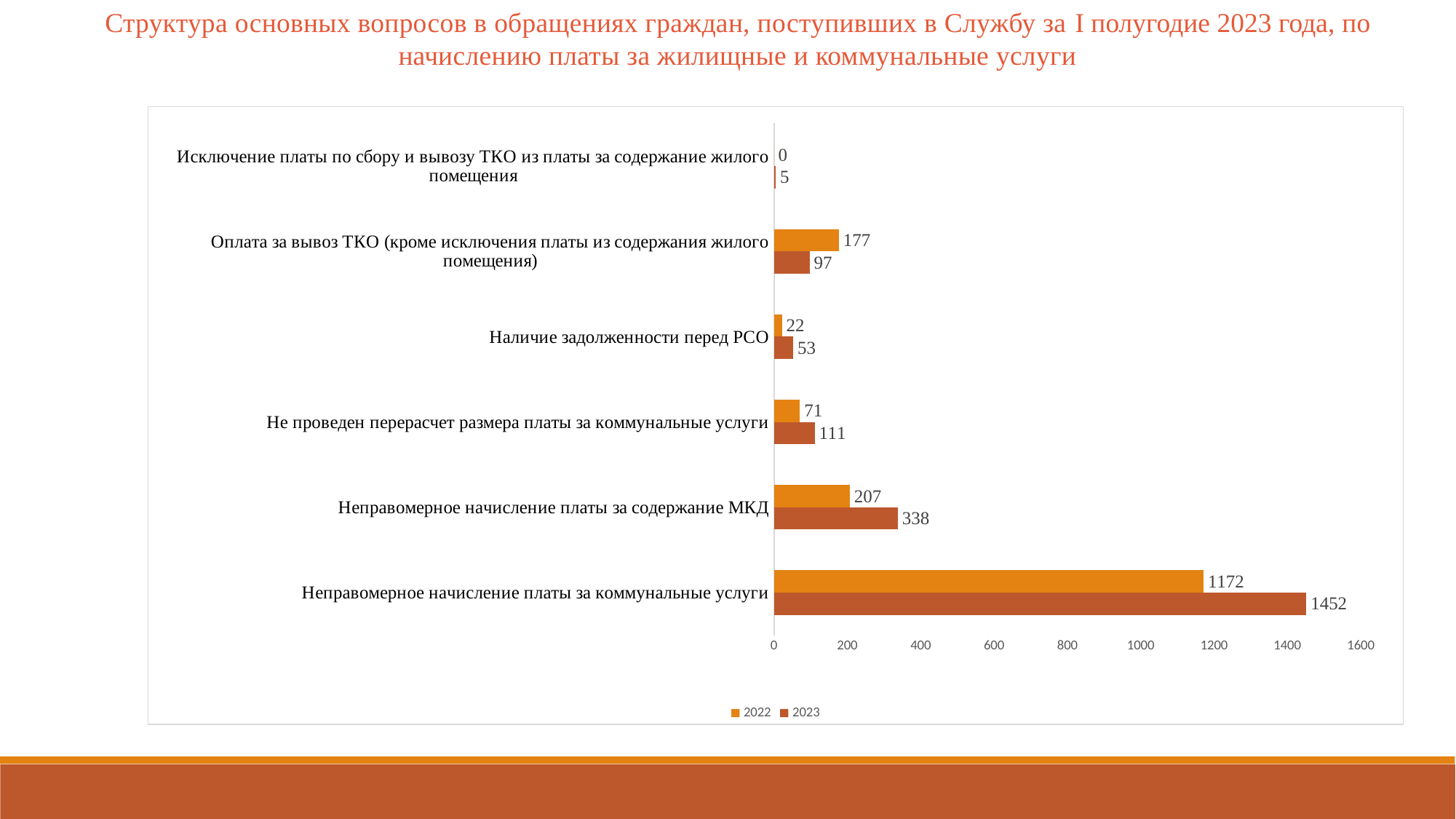
What is the 2023 value for «Неправомерное начисление платы за коммунальные услуги»? 1452 What type of chart is shown on the slide? Bar chart What is the difference between the 2023 and 2022 values for «Неправомерное начисление платы за коммунальные услуги»? 280 What is the 2022 value for «Оплата за вывоз ТКО (кроме исключения платы из содержания жилого помещения)»? 177 What is the 2023 value for «Наличие задолженности перед РСО»? 53 Which category has the lowest 2022 value? Исключение платы по сбору и вывозу ТКО из платы за содержание жилого помещения For «Оплата за вывоз ТКО (кроме исключения платы из содержания жилого помещения)», which year has the larger value, 2022 or 2023? 2022 How many series does the legend list? 2 How many categories are shown on the chart? 6 What is the 2022 value for «Неправомерное начисление платы за содержание МКД»? 207 For «Не проведен перерасчет размера платы за коммунальные услуги», which year has the larger value, 2022 or 2023? 2023 Which category has the highest 2023 value? Неправомерное начисление платы за коммунальные услуги